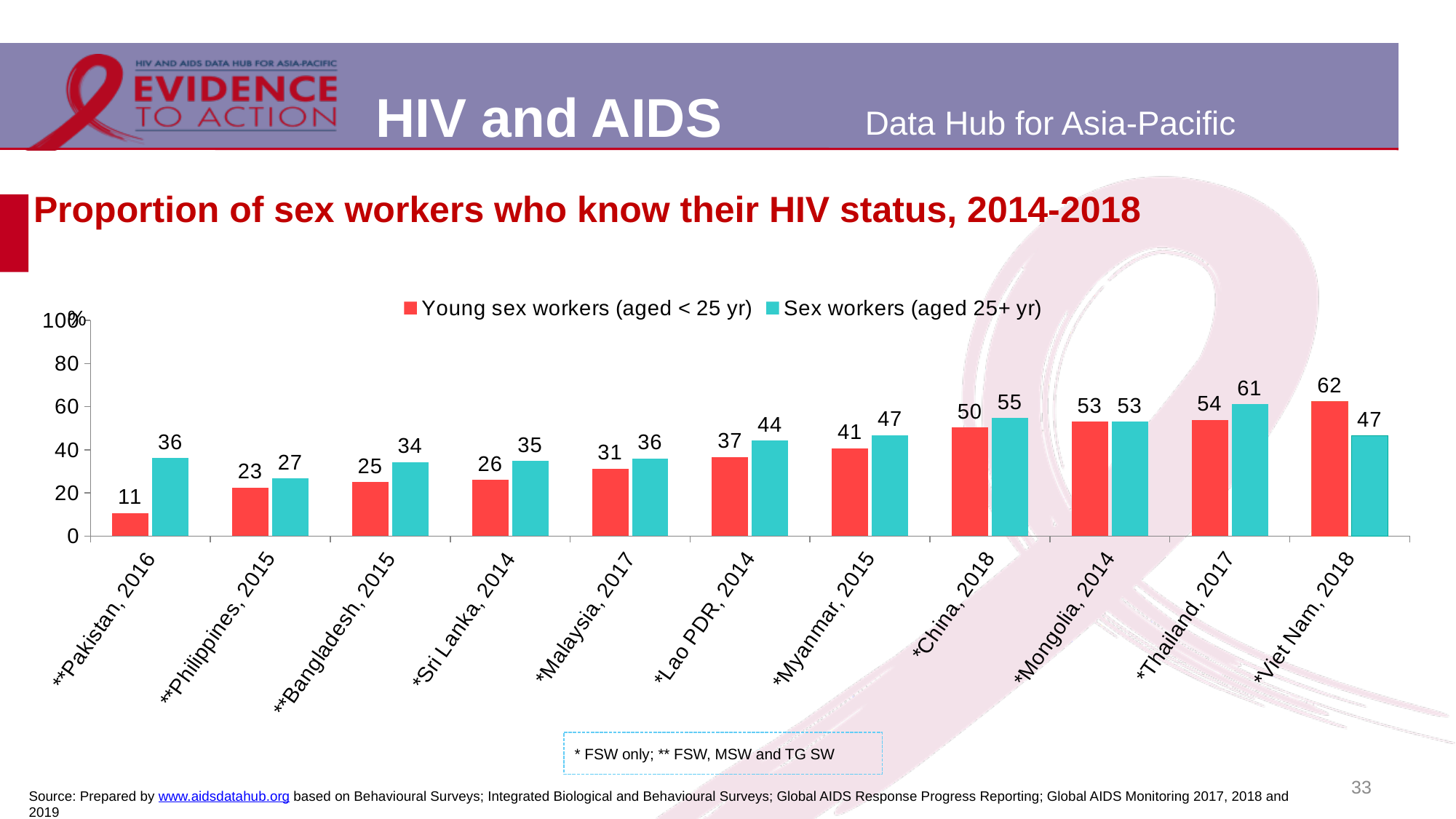
How many countries are shown on the x axis? 11 Which category has the lowest value for sex workers (aged 25+ yr)? **Philippines, 2015 How many series does the legend list? 2 What is the value for young sex workers (aged < 25 yr) in **Pakistan, 2016? 11 What is the value for young sex workers (aged < 25 yr) in *Viet Nam, 2018? 62 What is the value for sex workers (aged 25+ yr) in *Thailand, 2017? 61 What is the difference between the sex workers (aged 25+ yr) value and the young sex workers (aged < 25 yr) value for **Pakistan, 2016? 25 Which category has the highest value for young sex workers (aged < 25 yr)? *Viet Nam, 2018 Is the value for sex workers (aged 25+ yr) in *China, 2018 greater or less than 40? greater What kind of chart is shown on the slide? Bar chart What is the title of the chart? Proportion of sex workers who know their HIV status, 2014-2018 Which is larger for *Viet Nam, 2018: the value for young sex workers (aged < 25 yr) or for sex workers (aged 25+ yr)? Young sex workers (aged < 25 yr)